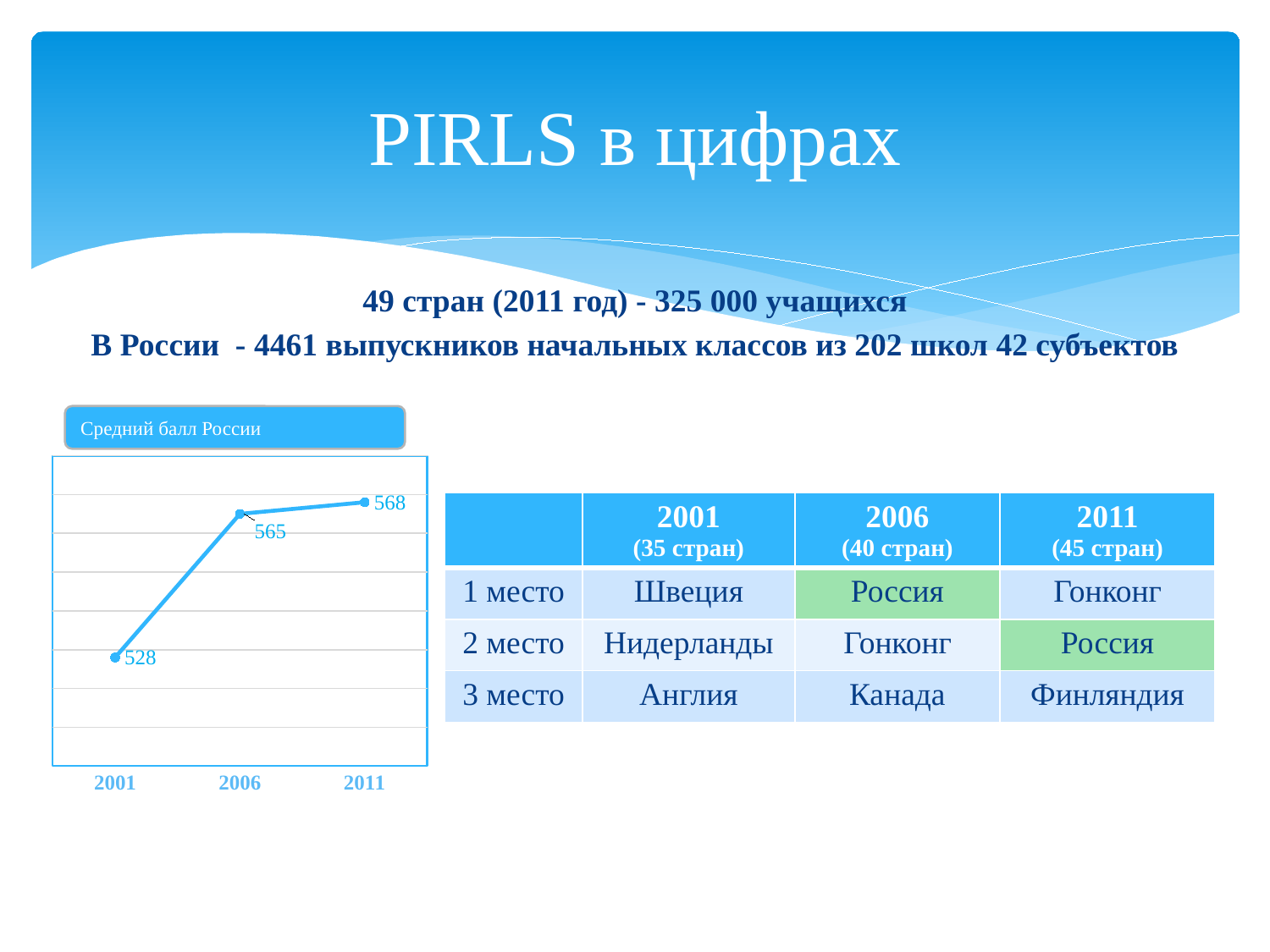
What is the average score of Russia in 2001 on the chart? 528 What is the average score of Russia in 2011 on the chart? 568 What is the average score of Russia in 2006 on the chart? 565 How many data points are plotted on the chart? 3 What type of chart is shown on the slide? line chart Which is larger, Russia's average score in 2001 or in 2006? 2006 By how much did Russia's average score increase from 2006 to 2011? 3 By how much did Russia's average score increase from 2001 to 2006? 37 In which year is Russia's average score highest on the chart? 2011 Does Russia's average score rise or fall from 2001 to 2011 on the chart? rise What is the difference between Russia's average score in 2011 and in 2001? 40 In which year is Russia's average score lowest on the chart? 2001